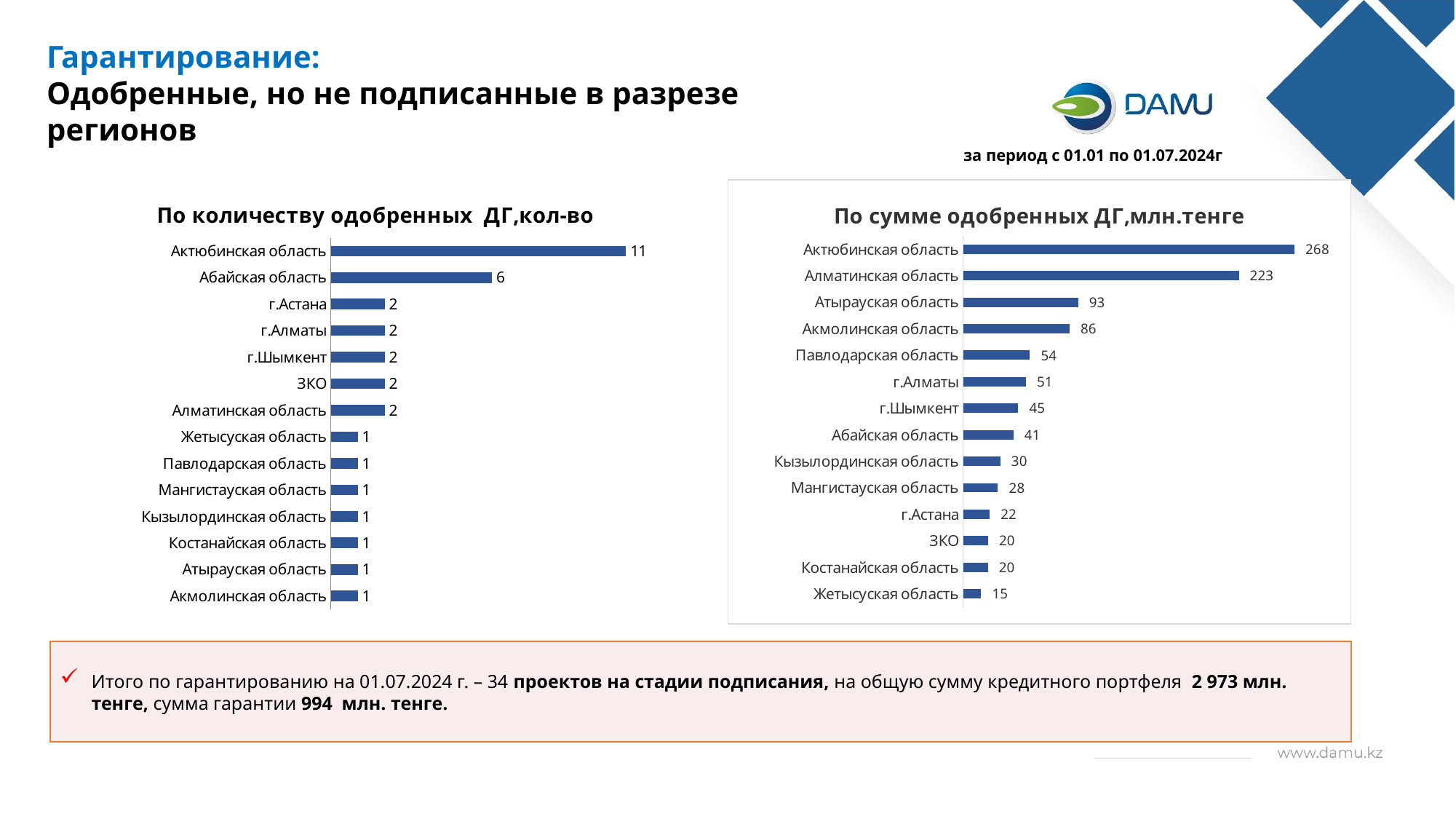
In the chart 'По количеству одобренных ДГ,кол-во', how many regions are shown? 14 In the chart 'По количеству одобренных ДГ,кол-во', what is the value for Абайская область? 6 In the chart 'По количеству одобренных ДГ,кол-во', what is the difference between Актюбинская область and Абайская область? 5 In the chart 'По сумме одобренных ДГ,млн.тенге', which region has the lowest value? Жетысуская область In the chart 'По сумме одобренных ДГ,млн.тенге', what is the difference between Актюбинская область and Алматинская область? 45 In the chart 'По сумме одобренных ДГ,млн.тенге', what is the value for Павлодарская область? 54 In the chart 'По количеству одобренных ДГ,кол-во', what is the value for Актюбинская область? 11 What type of chart is 'По сумме одобренных ДГ,млн.тенге'? Bar chart In the chart 'По сумме одобренных ДГ,млн.тенге', which is larger: Атырауская область or Акмолинская область? Атырауская область In the chart 'По сумме одобренных ДГ,млн.тенге', what is the value for г.Астана? 22 In the chart 'По сумме одобренных ДГ,млн.тенге', what is the value for Алматинская область? 223 In the chart 'По количеству одобренных ДГ,кол-во', which region has the highest value? Актюбинская область